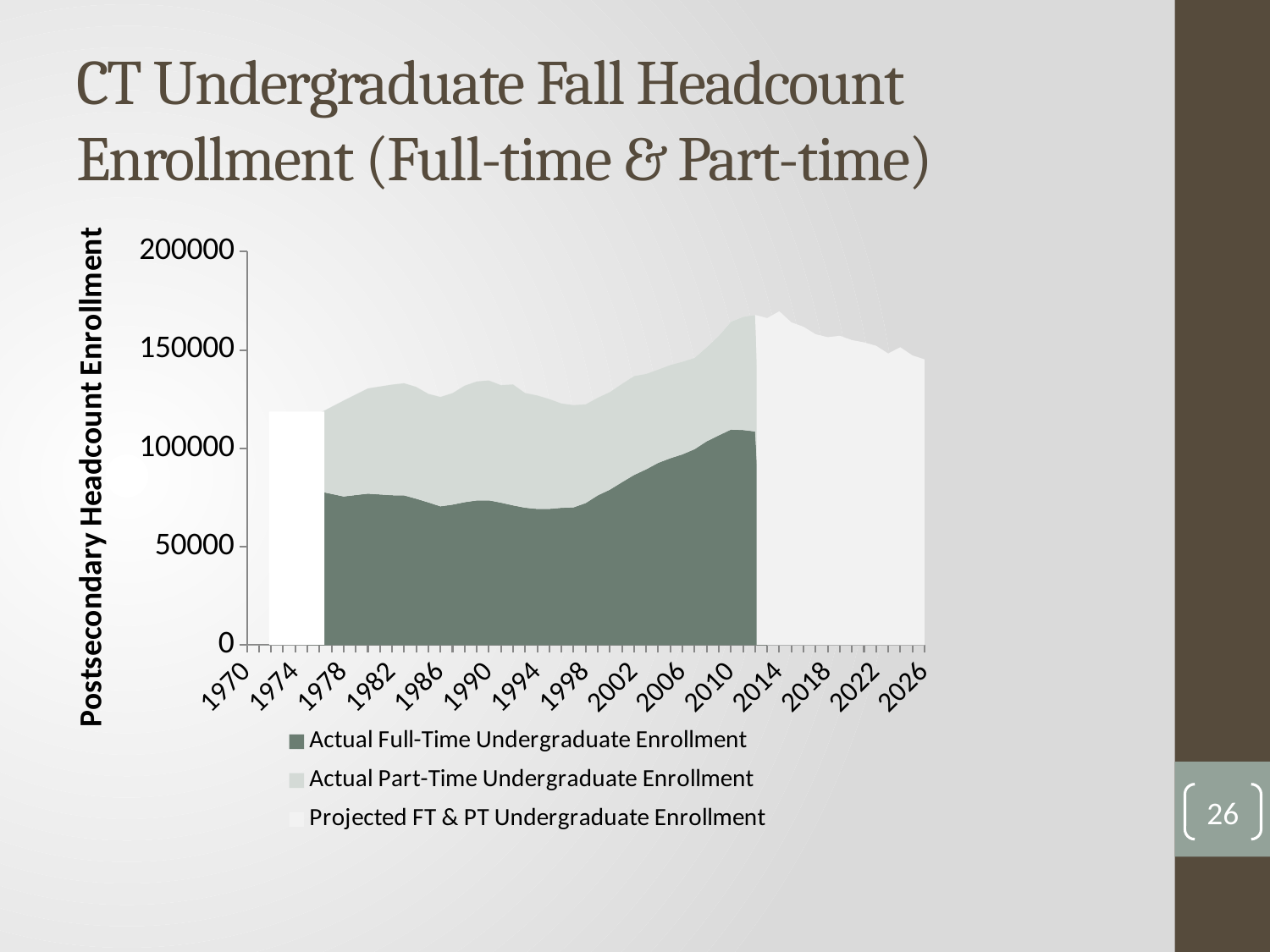
Is the Actual Full-Time Undergraduate Enrollment in 1978 greater or less than 100000? less Which legend entry is shown in the darkest colour? Actual Full-Time Undergraduate Enrollment What is the title of the vertical axis? Postsecondary Headcount Enrollment Is the Actual Full-Time Undergraduate Enrollment in 1994 greater or less than 50000? greater Does the Projected FT & PT Undergraduate Enrollment rise or fall between 2014 and 2026? Fall How many series does the legend list? 3 Is the Actual Full-Time Undergraduate Enrollment in 2010 greater or less than 100000? greater Does the Actual Full-Time Undergraduate Enrollment rise or fall between 1998 and 2010? Rise Which is larger: the Actual Full-Time Undergraduate Enrollment in 2010 or in 1978? 2010 What kind of chart is shown on the slide? Area chart